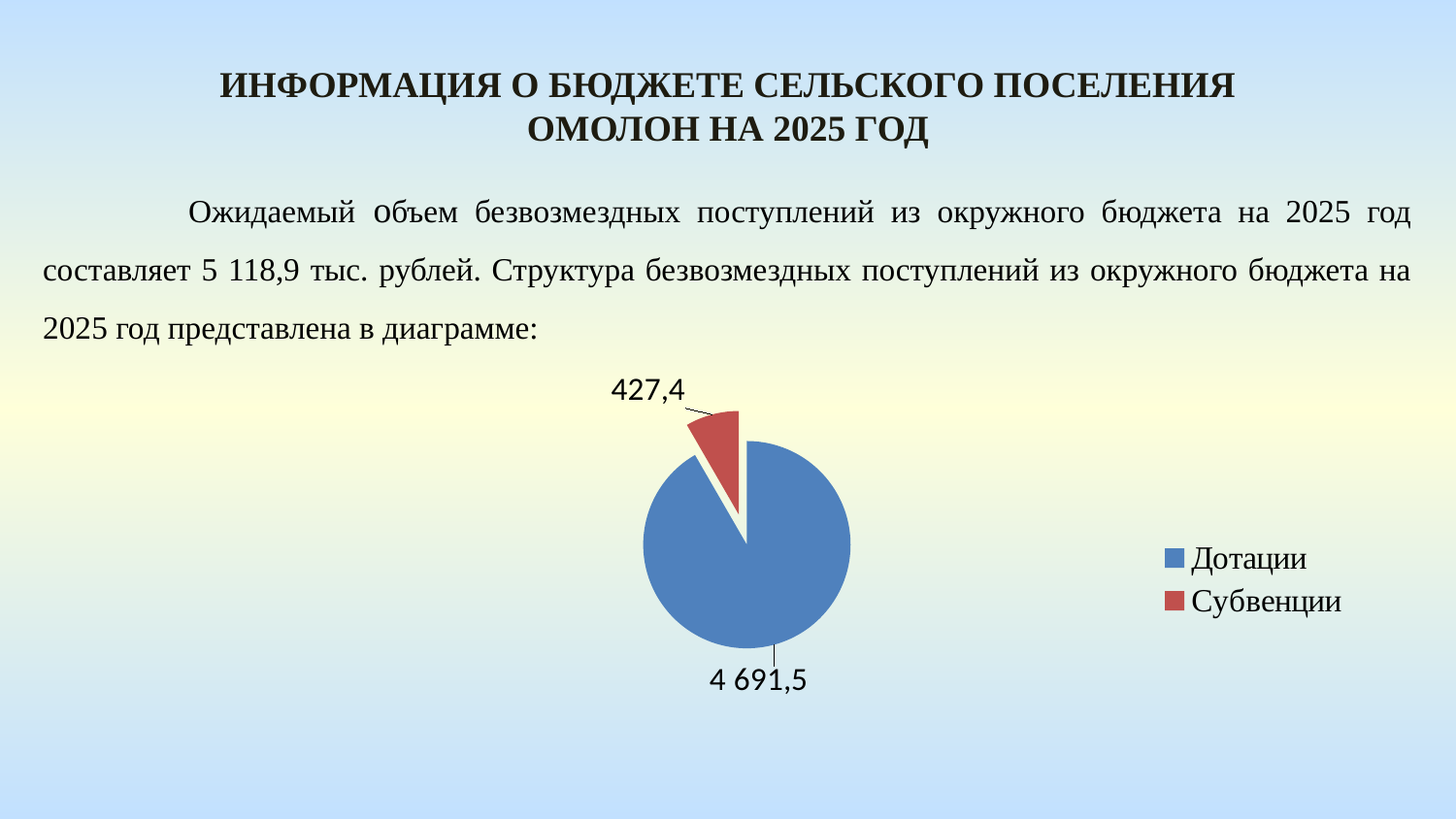
What value is shown for the Дотации slice of the pie chart? 4 691,5 Which category has the largest slice in the pie chart? Дотации How many entries does the legend of the pie chart list? 2 What type of chart is shown on the slide? Pie chart What colour is the Дотации slice in the pie chart? Blue Which is larger in the pie chart, Дотации or Субвенции? Дотации How many slices does the pie chart have? 2 Which category has the smallest slice in the pie chart? Субвенции What value is shown for the Субвенции slice of the pie chart? 427,4 What colour is the Субвенции slice in the pie chart? Red What is the difference between the Дотации value and the Субвенции value in the pie chart? 4 264,1 What is the total of the two values shown in the pie chart? 5 118,9